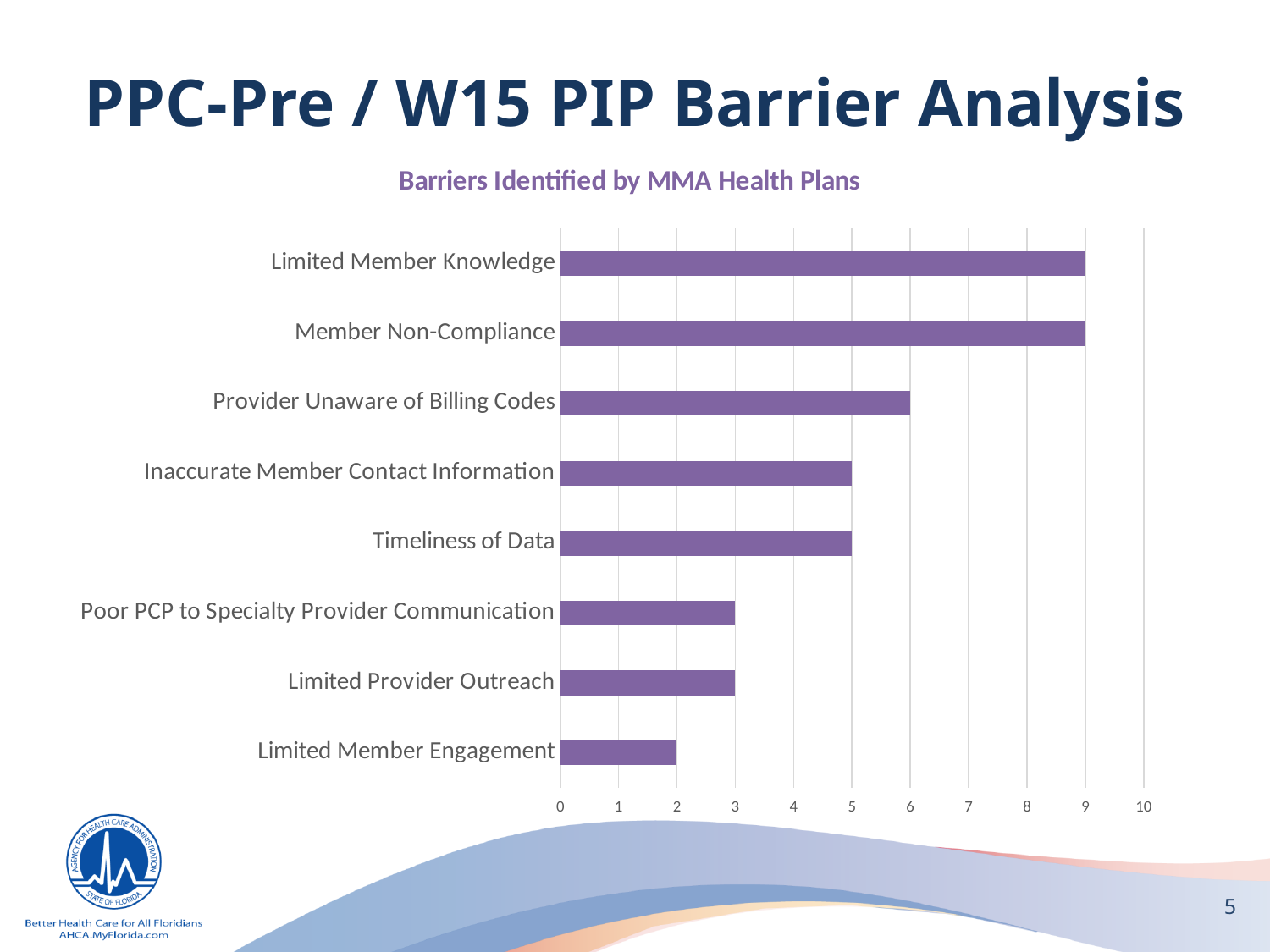
What is the title of the chart? Barriers Identified by MMA Health Plans What is the difference between the values for Member Non-Compliance and Provider Unaware of Billing Codes? 3 Which is larger, the value for Inaccurate Member Contact Information or the value for Limited Provider Outreach? Inaccurate Member Contact Information Which barrier has the lowest value? Limited Member Engagement What is the value for Provider Unaware of Billing Codes? 6 What is the value for Limited Member Engagement? 2 What is the difference between the values for Limited Member Knowledge and Limited Member Engagement? 7 What type of chart is shown on the slide? bar chart What is the value for Limited Member Knowledge? 9 What is the value for Timeliness of Data? 5 How many barriers (categories) are plotted in the chart? 8 Is the value for Poor PCP to Specialty Provider Communication greater or less than 5? less